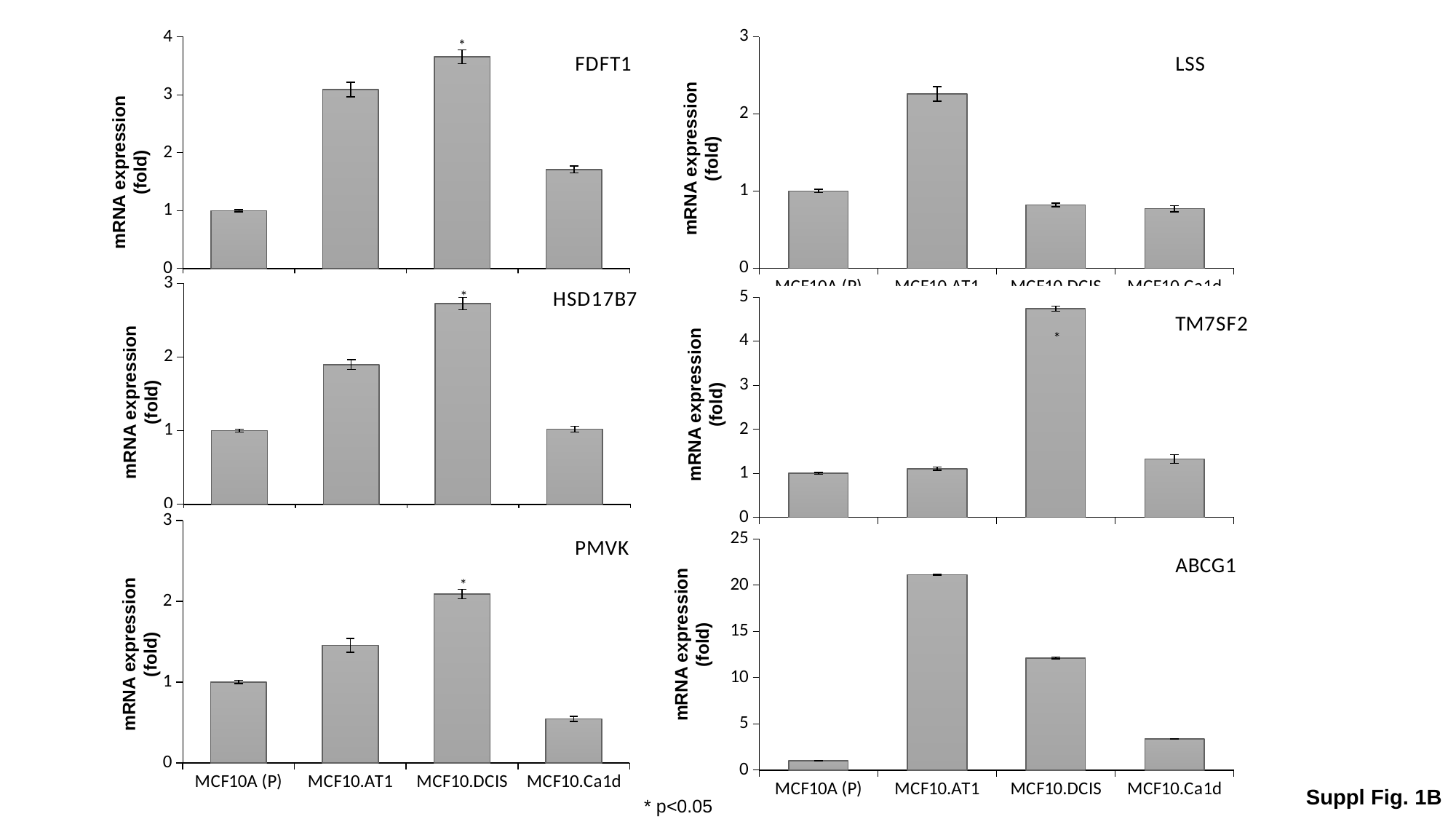
In the TM7SF2 chart, which is larger, the value for MCF10.DCIS or the value for MCF10.Ca1d? MCF10.DCIS In the PMVK chart, is the value for MCF10.Ca1d greater or less than 1? less What type of chart is the TM7SF2 chart? bar chart In the PMVK chart, which category has the lowest mRNA expression? MCF10.Ca1d In the LSS chart, is the value for MCF10.DCIS greater or less than 1? less How many categories are shown on the x axis of the ABCG1 chart? 4 In the ABCG1 chart, is the value for MCF10.AT1 greater or less than 20? greater In the LSS chart, which category has the highest mRNA expression? MCF10.AT1 In the HSD17B7 chart, what is the mRNA expression value for MCF10A (P)? 1 In the FDFT1 chart, which category has the highest mRNA expression? MCF10.DCIS